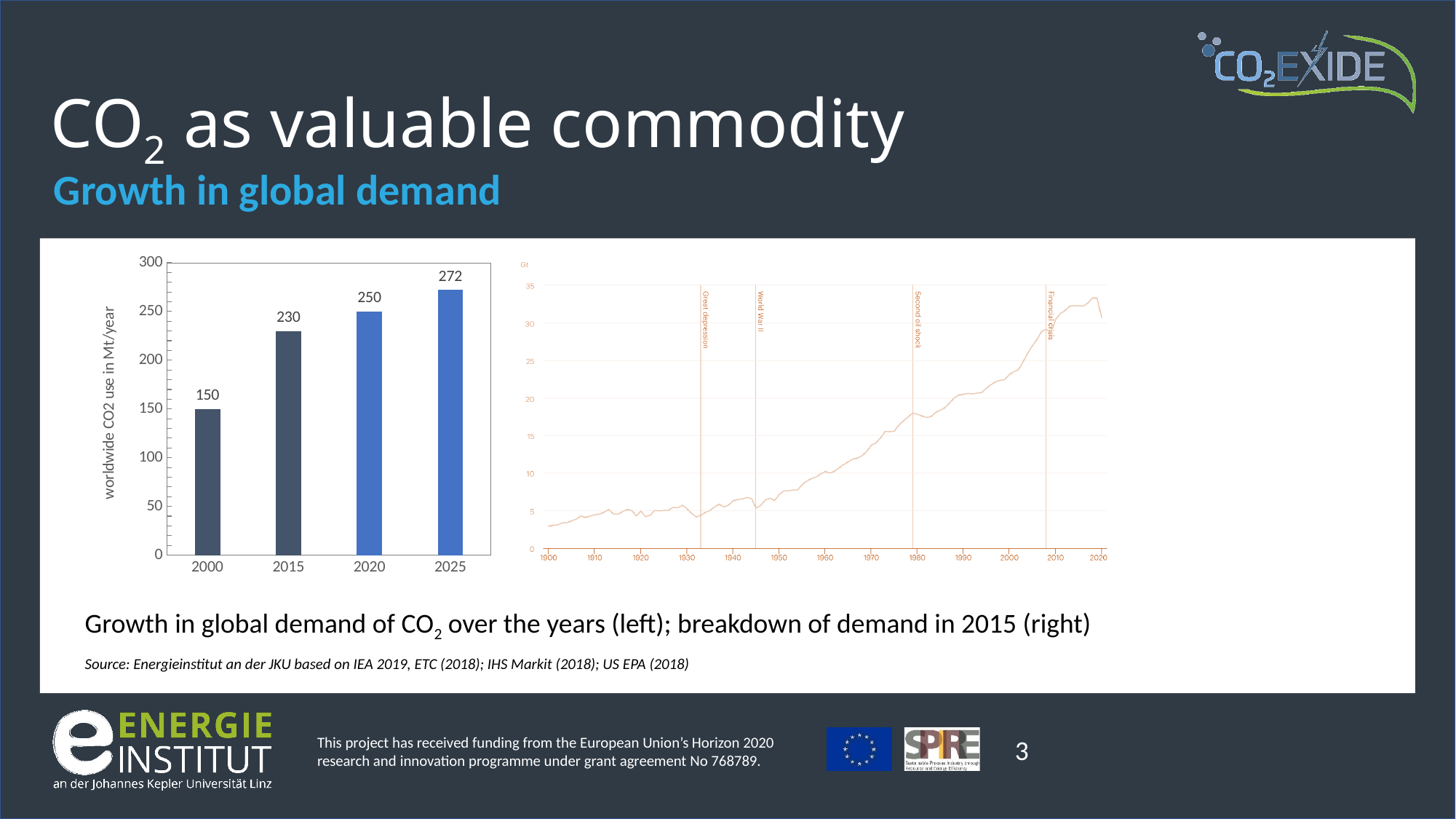
On the left bar chart, which is larger, the value for 2020 or the value for 2015? 2020 How many bars are shown on the left bar chart? 4 On the left bar chart, which year has the lowest worldwide CO2 use? 2000 On the left bar chart, do the values rise or fall from 2000 to 2025? Rise On the left bar chart, what is the difference between the values for 2025 and 2000? 122 On the left bar chart, what is the value shown for 2000? 150 What is the y-axis label of the left bar chart? worldwide CO2 use in Mt/year What kind of chart is the chart on the left of the slide? Bar chart On the left bar chart, what is the worldwide CO2 use for 2015? 230 On the right line chart, is the value for 2000 greater or less than 20 Gt? greater On the left bar chart, which year has the highest worldwide CO2 use? 2025 On the left bar chart, what is the value shown for 2025? 272